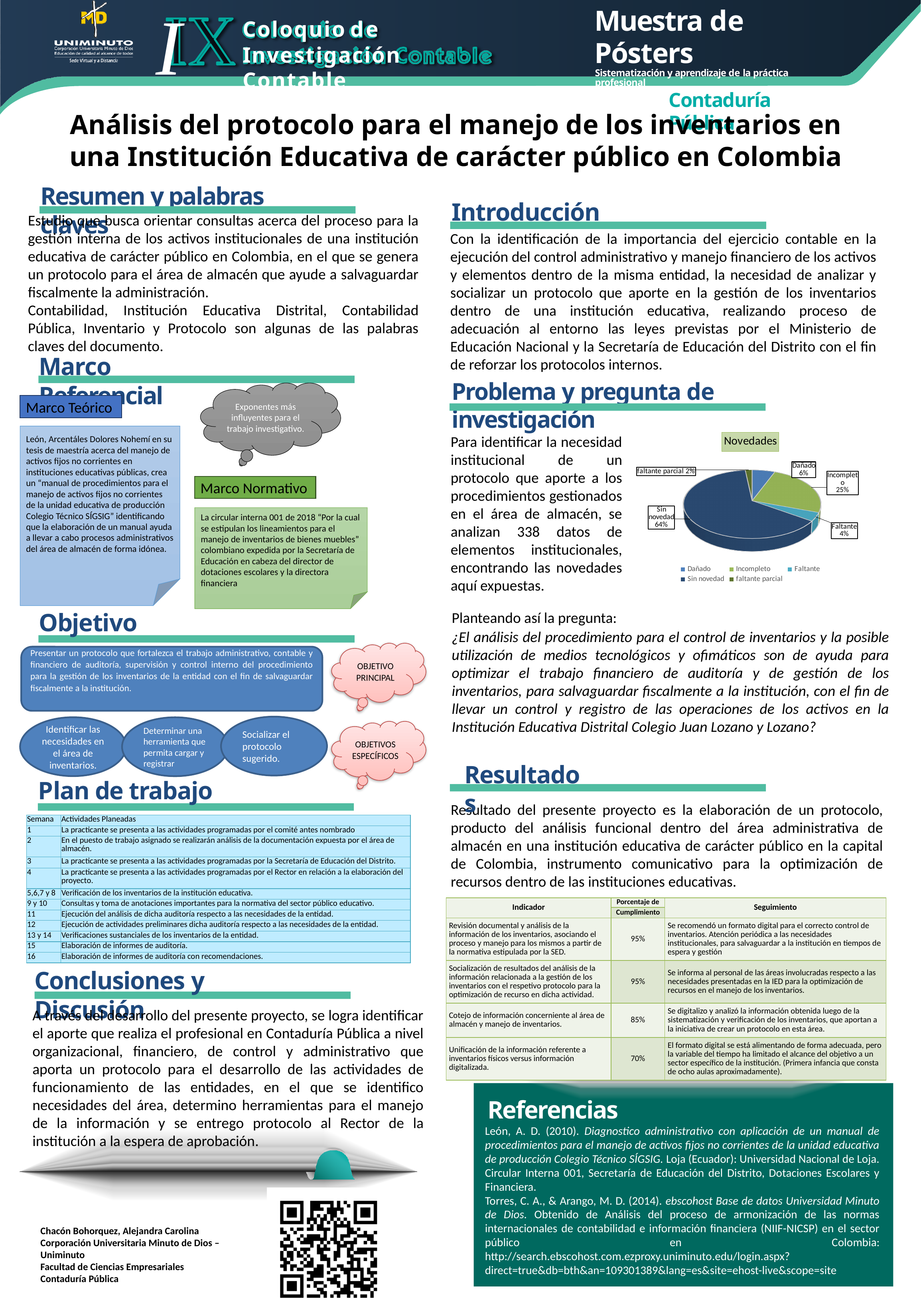
What type of chart is shown under the 'Problema y pregunta de investigación' section? pie chart In the Novedades pie chart, what percentage is labelled for 'Dañado'? 6% In the Novedades pie chart, what is the difference in percentage points between 'Sin novedad' and 'Incompleto'? 39 Which category has the largest share in the Novedades pie chart? Sin novedad In the Novedades pie chart, what percentage is labelled for 'Sin novedad'? 64% In the Novedades pie chart, what percentage is labelled for 'Faltante'? 4% What is the title of the pie chart? Novedades How many categories does the legend of the Novedades pie chart list? 5 In the Novedades pie chart, what percentage is labelled for 'Incompleto'? 25% In the Novedades pie chart, what percentage is labelled for 'faltante parcial'? 2% In the Novedades pie chart, which is larger: the share for 'Incompleto' or the share for 'Dañado'? Incompleto Which category has the smallest share in the Novedades pie chart? faltante parcial